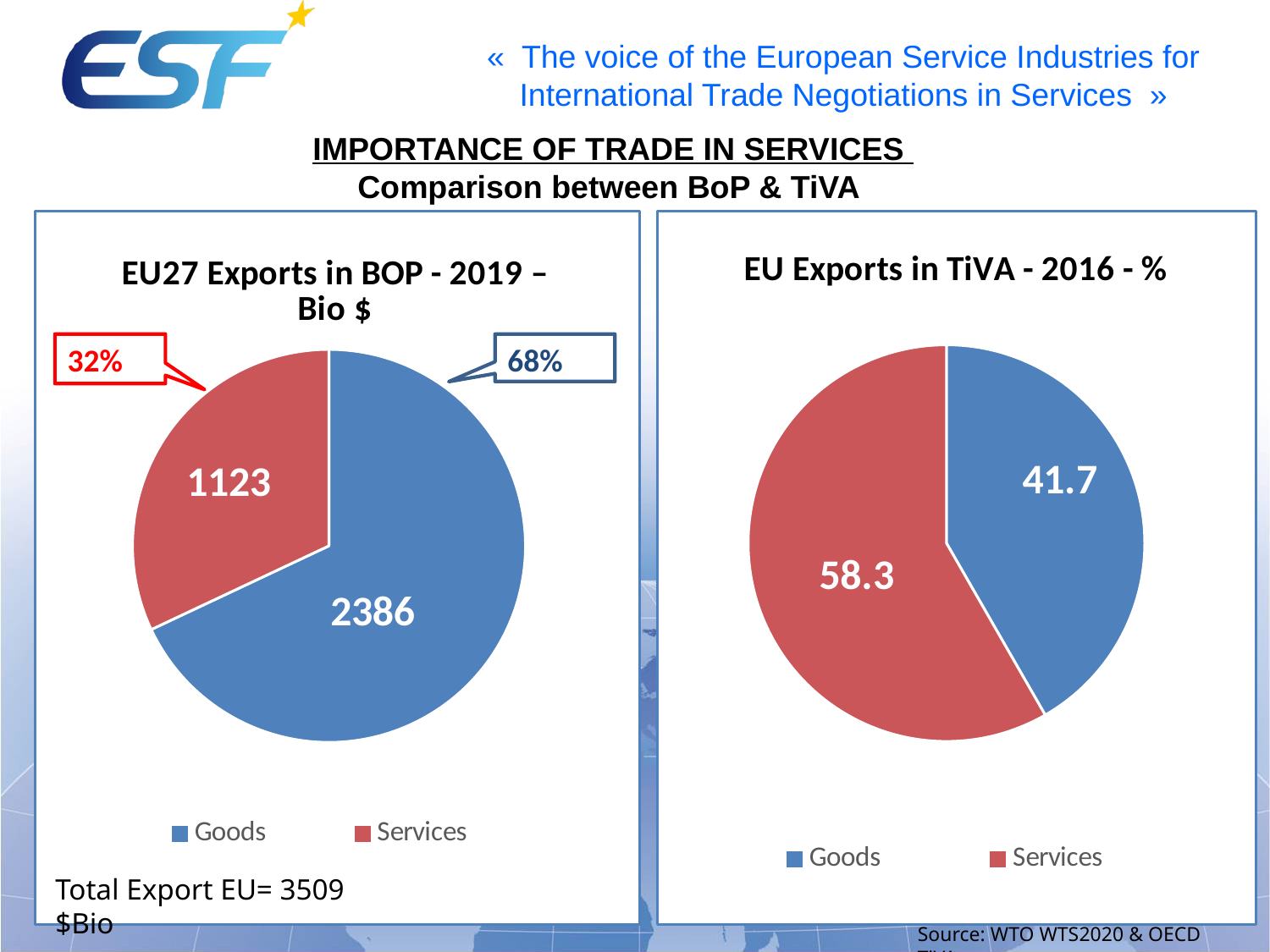
In the 'EU Exports in TiVA - 2016' chart, what is the value for Services? 58.3 In the 'EU Exports in TiVA - 2016' chart, which category has the smallest slice? Goods In the 'EU27 Exports in BOP - 2019' chart, what is the value for Services? 1123 What type of chart is the 'EU Exports in TiVA - 2016' chart? pie chart In the 'EU Exports in TiVA - 2016' chart, what colour is the Services slice? red In the 'EU27 Exports in BOP - 2019' chart, what share of the pie does Services represent, as labelled on the slide? 32% In the 'EU Exports in TiVA - 2016' chart, is the value for Services larger or smaller than the value for Goods? larger In the 'EU27 Exports in BOP - 2019' chart, what is the difference between the Goods and Services values? 1263 In the 'EU Exports in TiVA - 2016' chart, what is the value for Goods? 41.7 In the 'EU27 Exports in BOP - 2019' chart, what is the value for Goods? 2386 In the 'EU27 Exports in BOP - 2019' chart, which category has the largest slice? Goods How many series does the legend of the 'EU27 Exports in BOP - 2019' chart list? 2